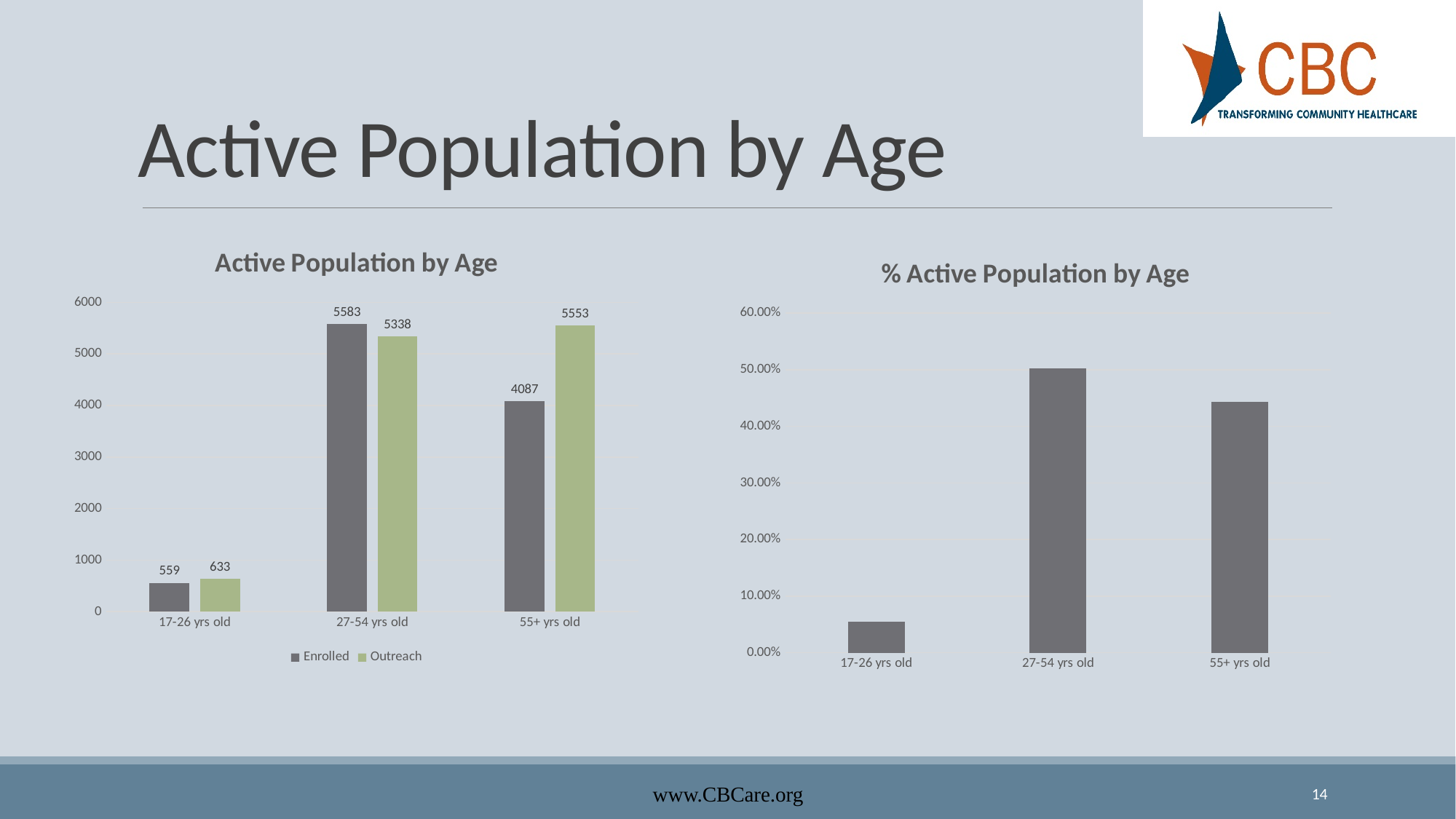
In the 'Active Population by Age' chart, what is the difference between the Outreach and Enrolled values for 55+ yrs old? 1466 In the 'Active Population by Age' chart, what is the Outreach value for 17-26 yrs old? 633 In the '% Active Population by Age' chart, is the value for 17-26 yrs old greater or less than 10.00%? less How many age groups are shown in the '% Active Population by Age' chart? 3 In the 'Active Population by Age' chart, which is larger for 27-54 yrs old, Enrolled or Outreach? Enrolled How many series does the legend of the 'Active Population by Age' chart list? 2 In the 'Active Population by Age' chart, which age group has the lowest Enrolled value? 17-26 yrs old In the '% Active Population by Age' chart, is the value for 55+ yrs old greater or less than 40.00%? greater In the 'Active Population by Age' chart, what is the Enrolled value for 27-54 yrs old? 5583 What kind of chart is the '% Active Population by Age' chart? bar chart In the 'Active Population by Age' chart, what is the Outreach value for 55+ yrs old? 5553 In the 'Active Population by Age' chart, which age group has the highest Enrolled value? 27-54 yrs old